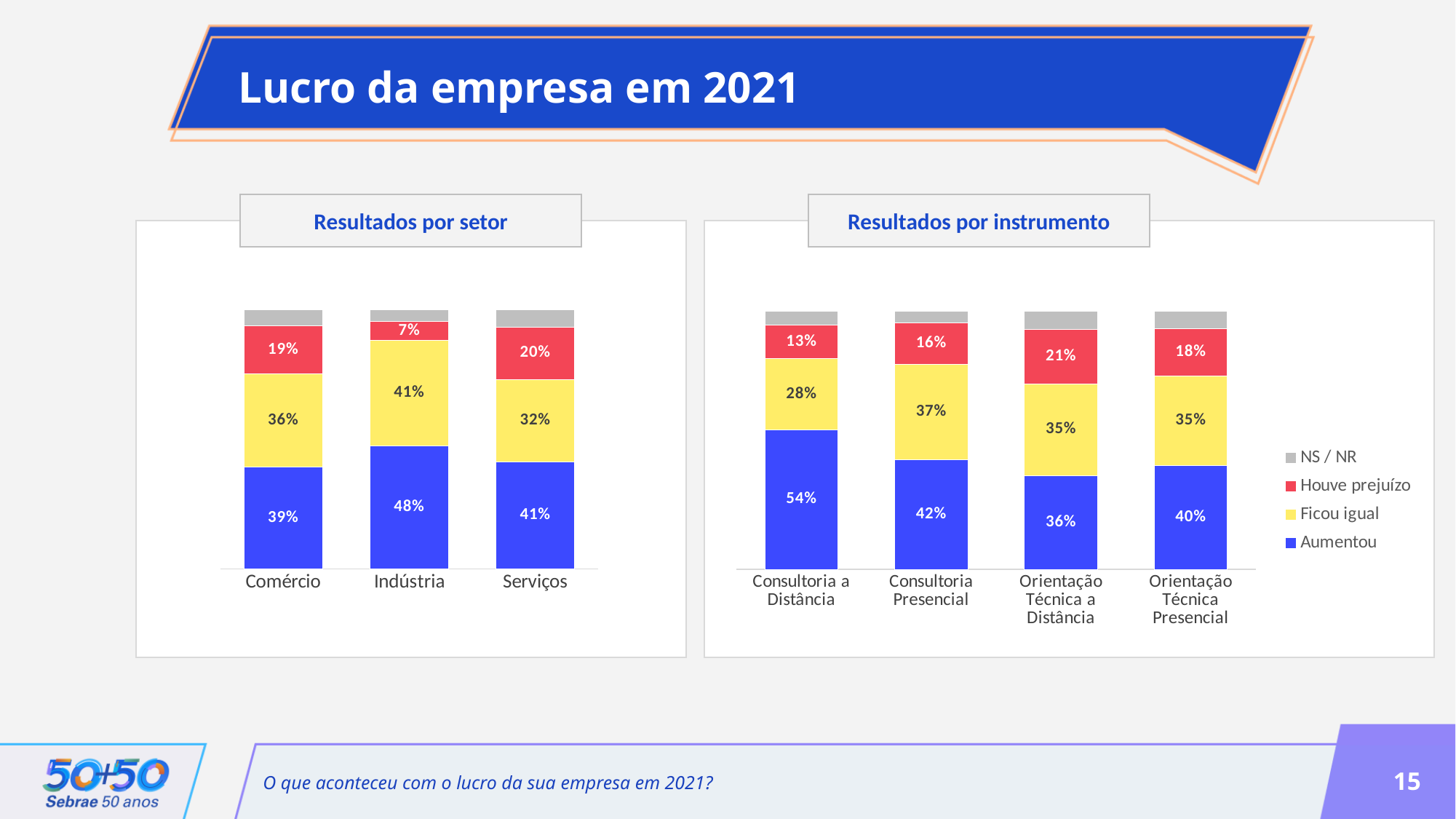
In the 'Resultados por instrumento' chart, which instrument has the lowest 'Aumentou' value? Orientação Técnica a Distância In the 'Resultados por instrumento' chart, what is the 'Houve prejuízo' value for Orientação Técnica a Distância? 21% How many series does the legend on the slide list? 4 In the 'Resultados por instrumento' chart, what is the difference between the 'Aumentou' values for Consultoria a Distância and Consultoria Presencial? 12% How many categories are shown on the x axis of the 'Resultados por instrumento' chart? 4 In the 'Resultados por setor' chart, which sector has the lowest 'Houve prejuízo' value? Indústria In the 'Resultados por instrumento' chart, is the 'Ficou igual' value larger for Consultoria Presencial or for Consultoria a Distância? Consultoria Presencial In the 'Resultados por setor' chart, what is the 'Aumentou' value for Indústria? 48% In the 'Resultados por setor' chart, which sector has the highest 'Aumentou' value? Indústria In the 'Resultados por setor' chart, what is the 'Houve prejuízo' value for Serviços? 20% In the 'Resultados por setor' chart, what is the difference between the 'Ficou igual' values for Indústria and Serviços? 9% In the 'Resultados por instrumento' chart, what is the 'Aumentou' value for Consultoria a Distância? 54%